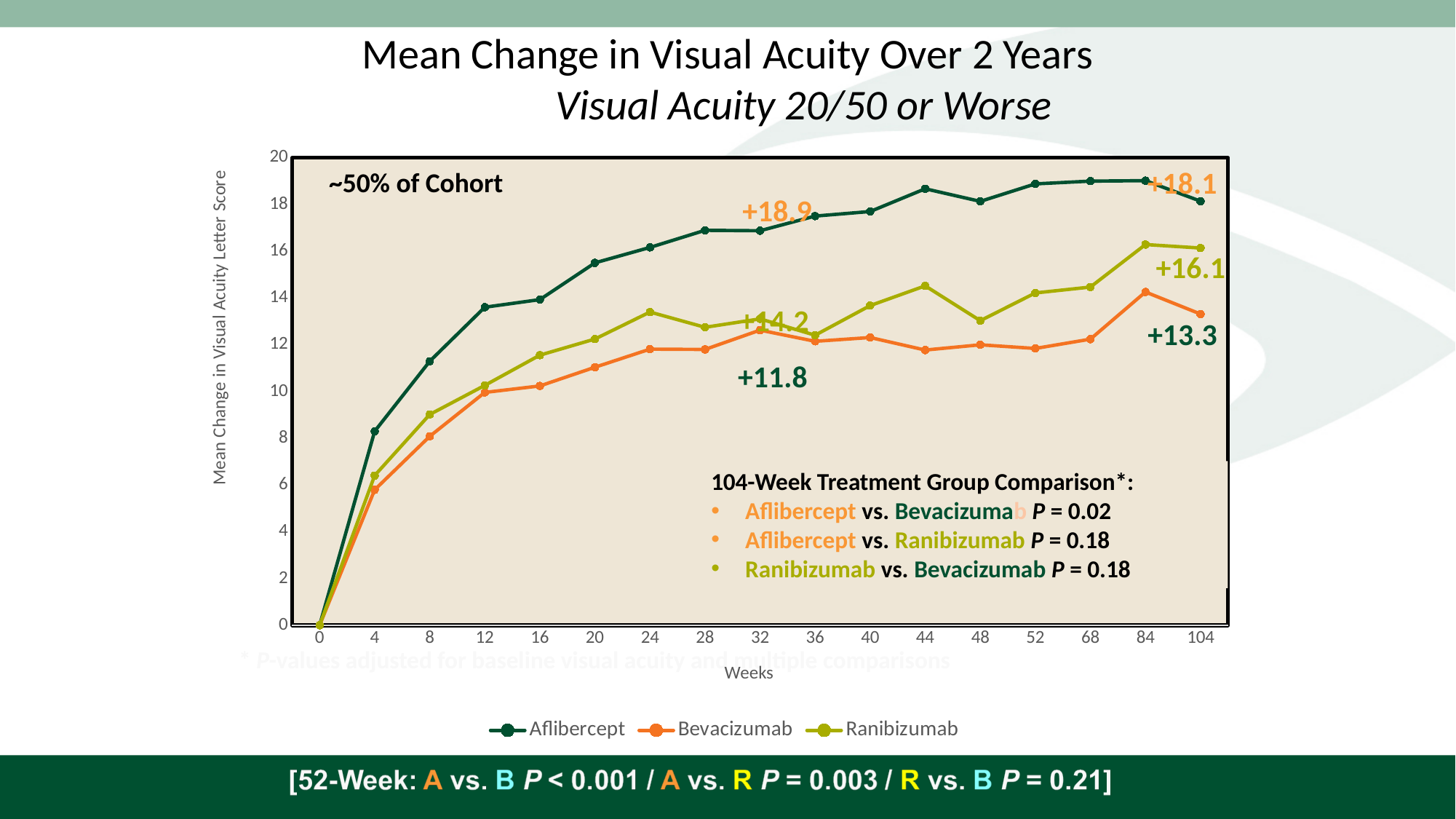
Is the value for Aflibercept at week 20 greater or less than 14? greater What is the labelled mean change in visual acuity letter score for Aflibercept at week 104? +18.1 At week 44, which is larger: the value for Ranibizumab or the value for Bevacizumab? Ranibizumab Which treatment group has the highest mean change at week 104? Aflibercept What is the title of the y axis? Mean Change in Visual Acuity Letter Score What is the difference between the week-104 values for Aflibercept (+18.1) and Bevacizumab (+13.3)? 4.8 How many week points are marked along the x axis? 17 Which treatment group has the lowest mean change at week 104? Bevacizumab What is the labelled mean change in visual acuity letter score for Ranibizumab at week 104? +16.1 How many series does the legend list? 3 What type of chart is shown on the slide? Line chart What is the labelled mean change in visual acuity letter score for Bevacizumab at week 104? +13.3